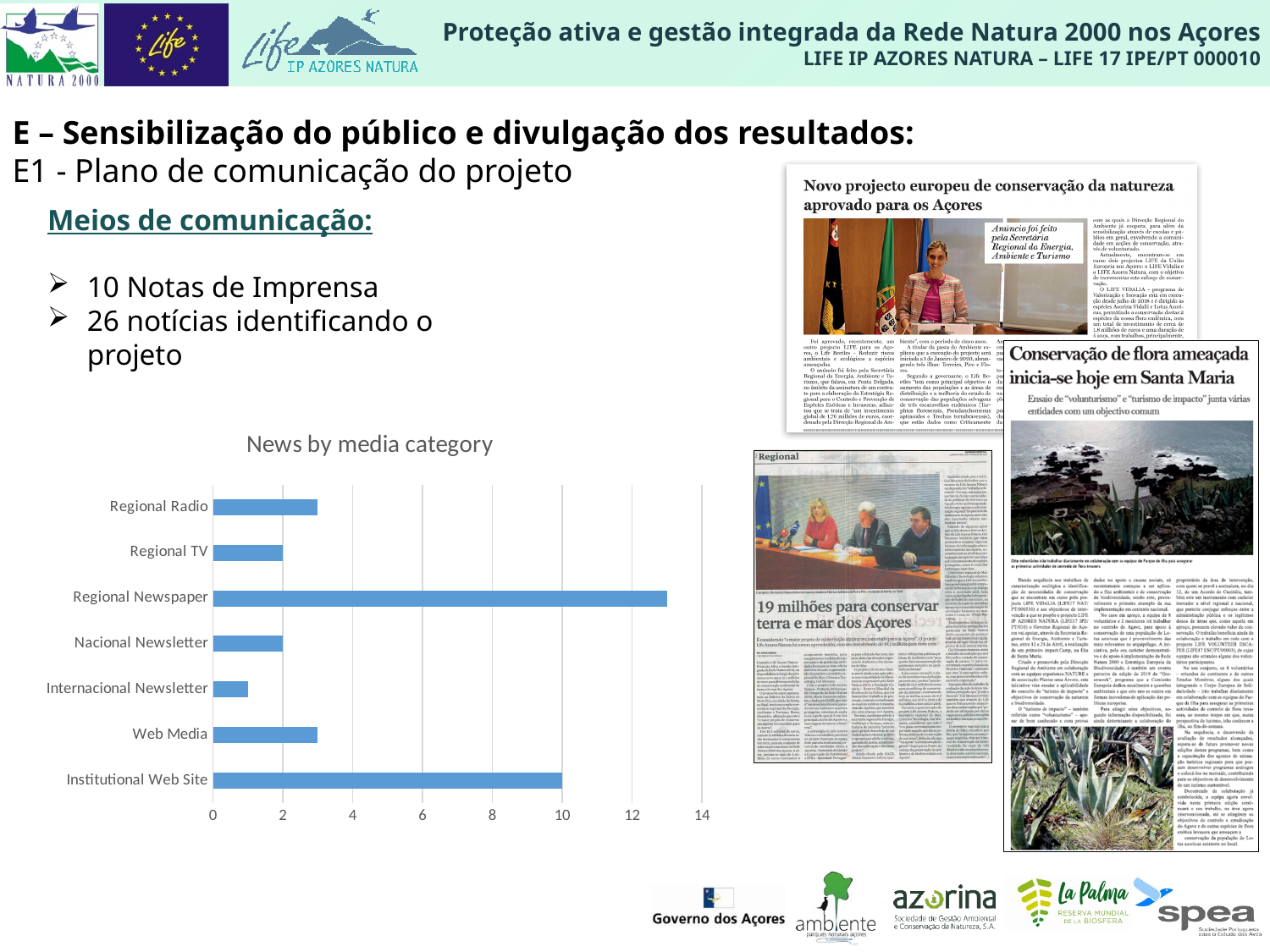
How many media categories are shown in the chart? 7 Which media category has the lowest number of news items? Internacional Newsletter What is the title of the chart on the slide? News by media category Which media category has the highest number of news items? Regional Newspaper Which has more news items, Institutional Web Site or Web Media? Institutional Web Site Which has more news items, Regional Newspaper or Regional Radio? Regional Newspaper Is the value for Regional Newspaper greater or less than 12? greater What kind of chart is used to show news by media category? bar chart Is the value for Internacional Newsletter greater or less than 2? less What is the value for Regional TV? 2 Is the value for Regional Radio greater or less than 2? greater What is the value for Institutional Web Site? 10